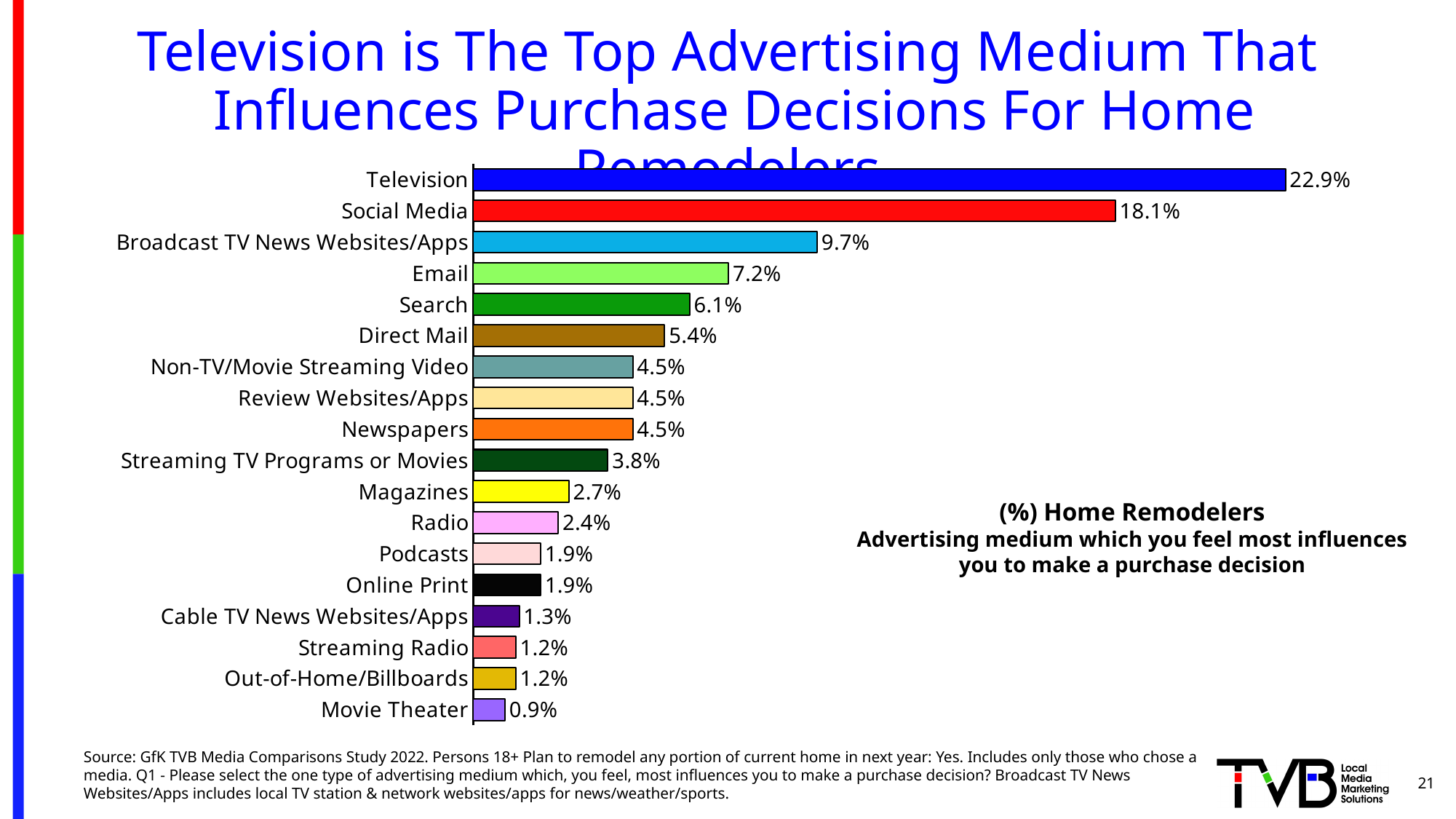
Which advertising medium has the highest value on the chart? Television What percentage of home remodelers chose Television as the advertising medium that most influences their purchase decision? 22.9% What is the value shown for Social Media? 18.1% What kind of chart is shown on the slide? Bar chart What is the difference between the values for Television and Social Media? 4.8% What is the value shown for Podcasts? 1.9% Which advertising medium has the lowest value on the chart? Movie Theater What colour is the bar for Social Media? Red What is the value shown for Direct Mail? 5.4% Which has a larger value, Search or Magazines? Search How many advertising media categories are shown on the chart? 18 What is the difference between the values for Broadcast TV News Websites/Apps and Email? 2.5%